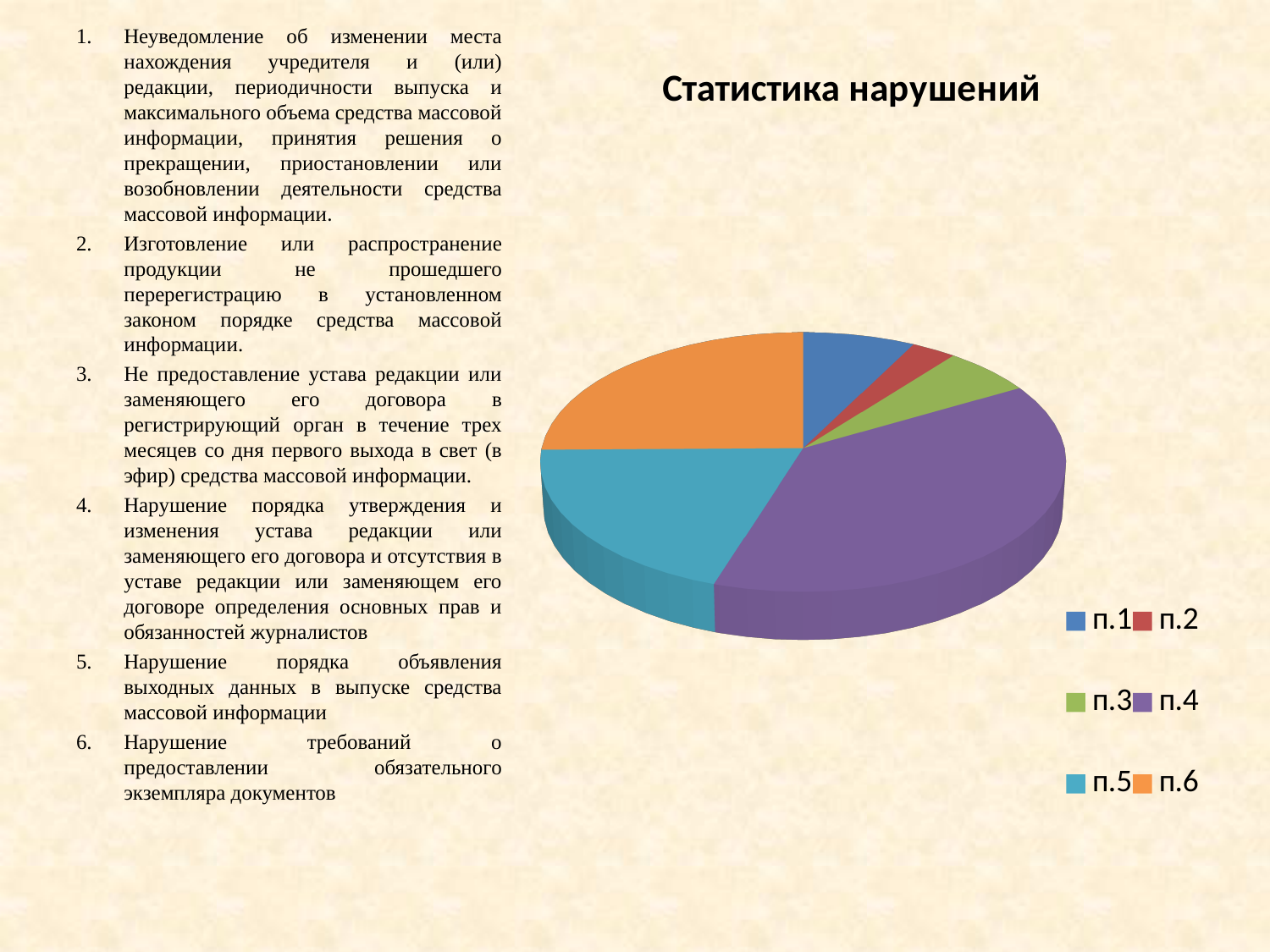
Which slice is larger, п.4 or п.1? п.4 What is the title of the chart? Статистика нарушений Which slice is larger, п.6 or п.5? п.6 What colour is the slice for п.4 in the pie chart? purple What kind of chart is shown on the slide? pie chart How many entries does the chart legend list? 6 Which slice is larger, п.6 or п.3? п.6 Which category has the largest slice of the pie? п.4 Which category has the smallest slice of the pie? п.2 How many slices does the pie chart have? 6